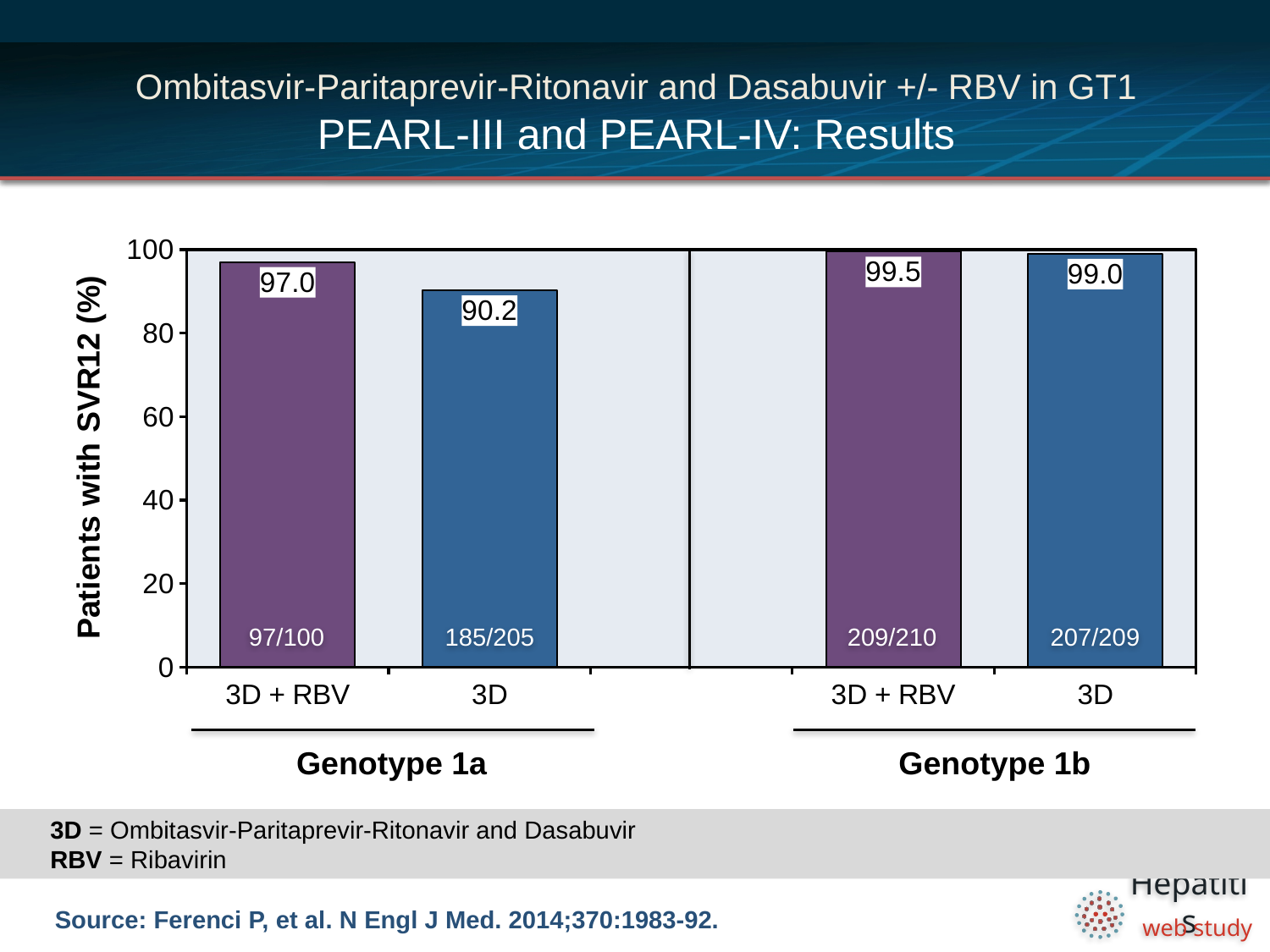
What fraction of patients is shown inside the 3D + RBV bar for Genotype 1b? 209/210 What fraction of patients is shown inside the 3D bar for Genotype 1a? 185/205 What does the abbreviation RBV stand for according to the slide? Ribavirin Which has a higher SVR12 rate in Genotype 1a: 3D + RBV or 3D? 3D + RBV What is the label of the y-axis? Patients with SVR12 (%) What is the difference in SVR12 rate between 3D + RBV and 3D in Genotype 1a? 6.8 How many bars are plotted in the chart? 4 What is the SVR12 rate for 3D alone in Genotype 1b? 99.0 Which bar has the highest SVR12 rate? 3D + RBV, Genotype 1b What kind of chart is shown on the slide? Bar chart What is the SVR12 rate for 3D + RBV in Genotype 1a? 97.0 Which bar has the lowest SVR12 rate? 3D, Genotype 1a